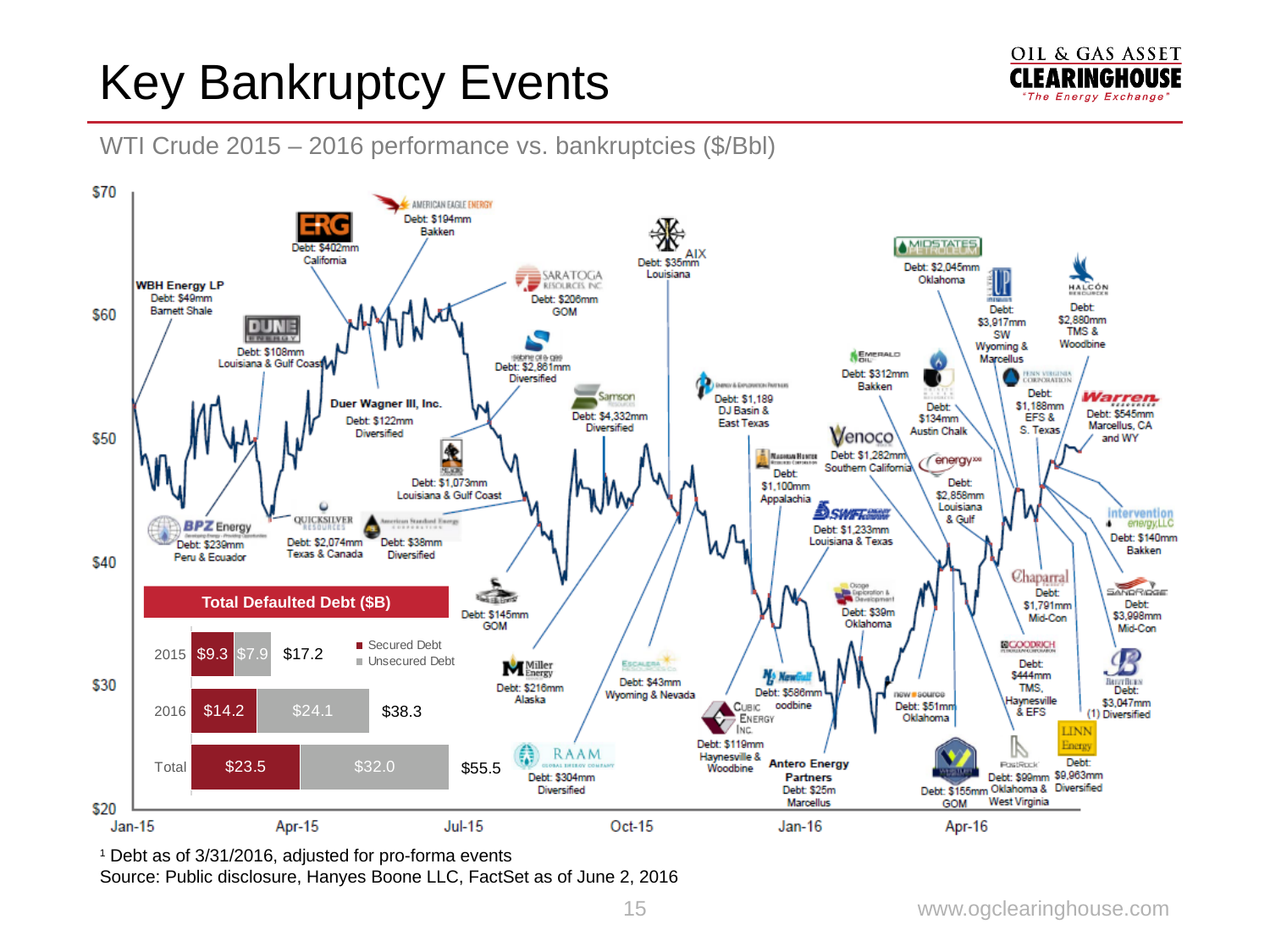
In the WTI Crude line chart, does the price overall rise or fall from Jan-15 to Apr-16? Fall In the Total Defaulted Debt ($B) inset chart, what is the secured debt for 2015? $9.3 In the Total Defaulted Debt ($B) inset chart, which is larger for 2016: secured debt or unsecured debt? Unsecured Debt In the Total Defaulted Debt ($B) inset chart, how much larger is the 2016 total than the 2015 total? $21.1 In the Total Defaulted Debt ($B) inset chart, what is the unsecured debt for 2016? $24.1 According to the annotation on the WTI Crude chart, what is the debt listed for Samson? $4,332mm In the WTI Crude line chart, is the price at Jan-16 greater or less than $40? less In the Total Defaulted Debt ($B) inset chart, what is the combined total of secured and unsecured debt across both years? $55.5 In the Total Defaulted Debt ($B) inset chart, what is the total defaulted debt for 2016? $38.3 What kind of chart shows the WTI Crude 2015 – 2016 performance? Line chart What kind of chart is the Total Defaulted Debt ($B) inset? Stacked bar chart How many series does the legend of the Total Defaulted Debt ($B) inset chart list? 2